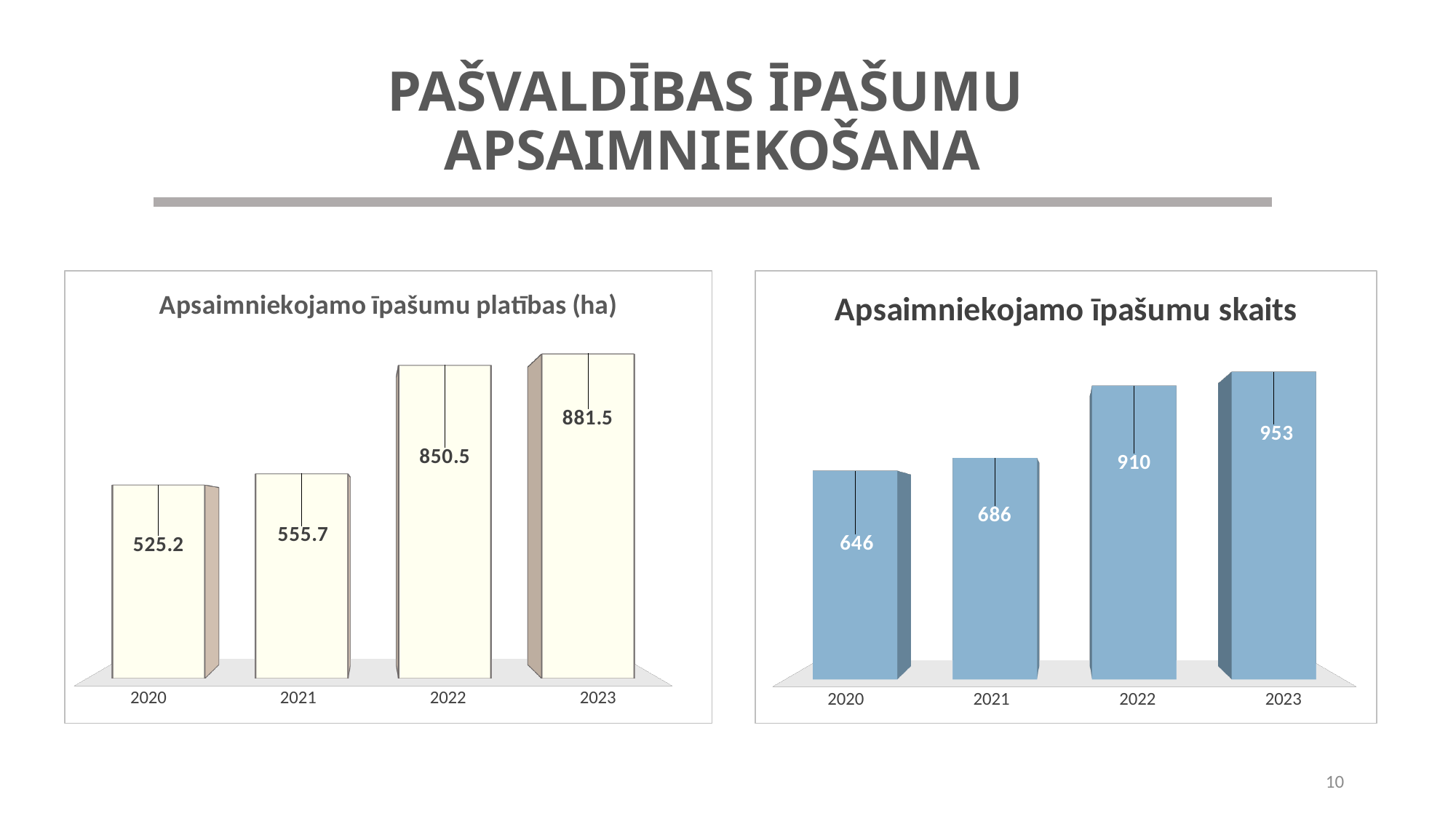
How many years are shown in the chart 'Apsaimniekojamo īpašumu skaits'? 4 In the chart 'Apsaimniekojamo īpašumu skaits', what is the value for 2021? 686 What kind of chart is 'Apsaimniekojamo īpašumu platības (ha)'? Bar chart In the chart 'Apsaimniekojamo īpašumu platības (ha)', which year has the highest value? 2023 In the chart 'Apsaimniekojamo īpašumu platības (ha)', what is the difference between the values for 2023 and 2022? 31.0 In the chart 'Apsaimniekojamo īpašumu skaits', what is the difference between the values for 2022 and 2021? 224 In the chart 'Apsaimniekojamo īpašumu skaits', do the values rise or fall from 2020 to 2023? Rise In the chart 'Apsaimniekojamo īpašumu skaits', which year has the lowest value? 2020 In the chart 'Apsaimniekojamo īpašumu skaits', what is the value for 2023? 953 In the chart 'Apsaimniekojamo īpašumu platības (ha)', what is the value for 2020? 525.2 In the chart 'Apsaimniekojamo īpašumu platības (ha)', which is larger, the value for 2021 or the value for 2022? 2022 In the chart 'Apsaimniekojamo īpašumu platības (ha)', what is the value for 2022? 850.5